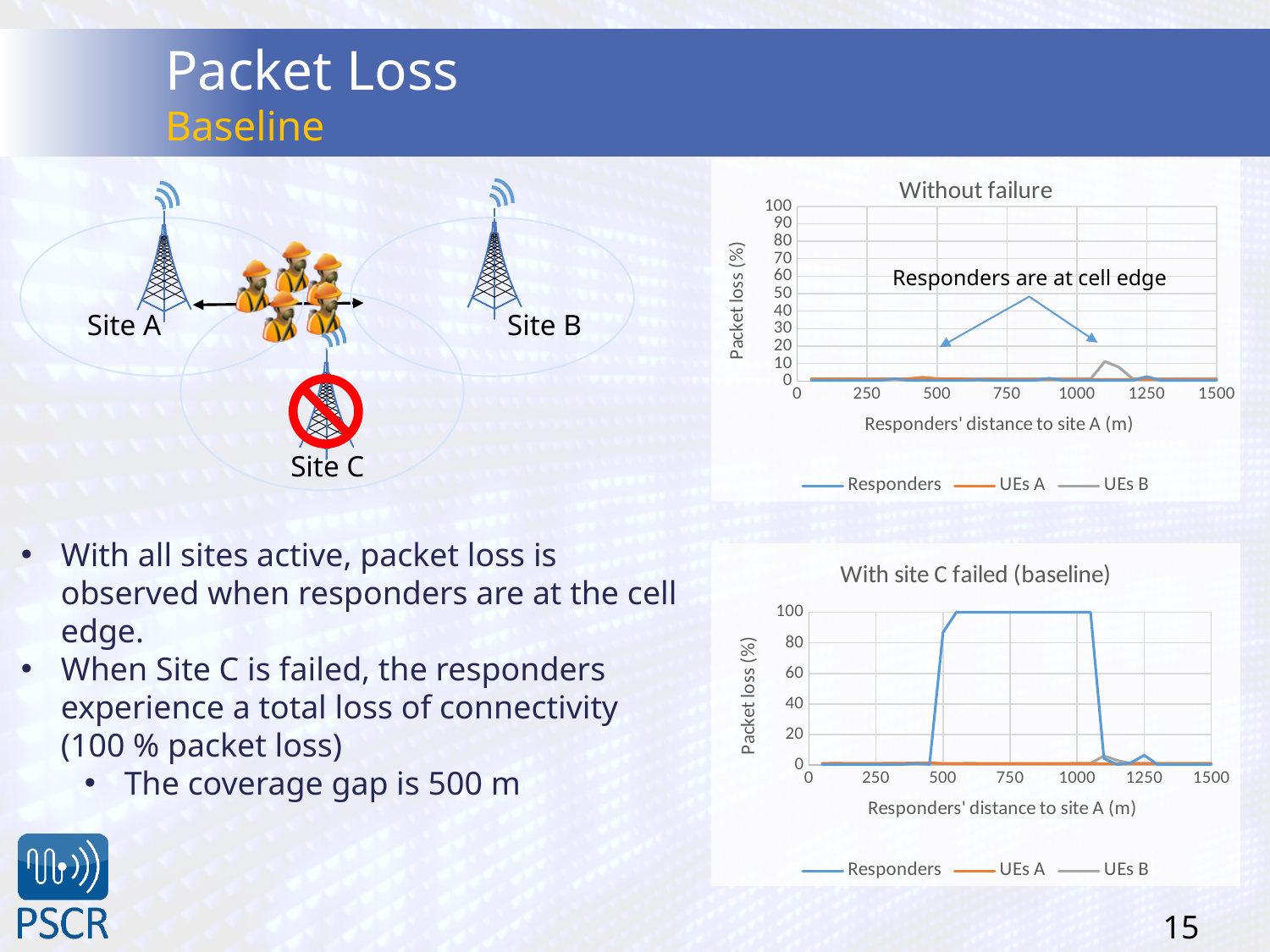
In the 'With site C failed (baseline)' chart, is the Responders packet loss at 750 m greater or less than 80? greater In the 'With site C failed (baseline)' chart, which series is higher at 750 m, Responders or UEs A? Responders What kind of chart is the 'With site C failed (baseline)' chart? line chart In the 'With site C failed (baseline)' chart, is the UEs A packet loss at 750 m greater or less than 20? less In the 'With site C failed (baseline)' chart, which series reaches the highest packet loss? Responders What is the y-axis label of the 'With site C failed (baseline)' chart? Packet loss (%) How many series does the legend of the 'Without failure' chart list? 3 What kind of chart is the 'Without failure' chart? line chart In the 'Without failure' chart, is the Responders packet loss at 750 m greater or less than 10? less What is the x-axis label of the 'Without failure' chart? Responders' distance to site A (m) How many series does the legend of the 'With site C failed (baseline)' chart list? 3